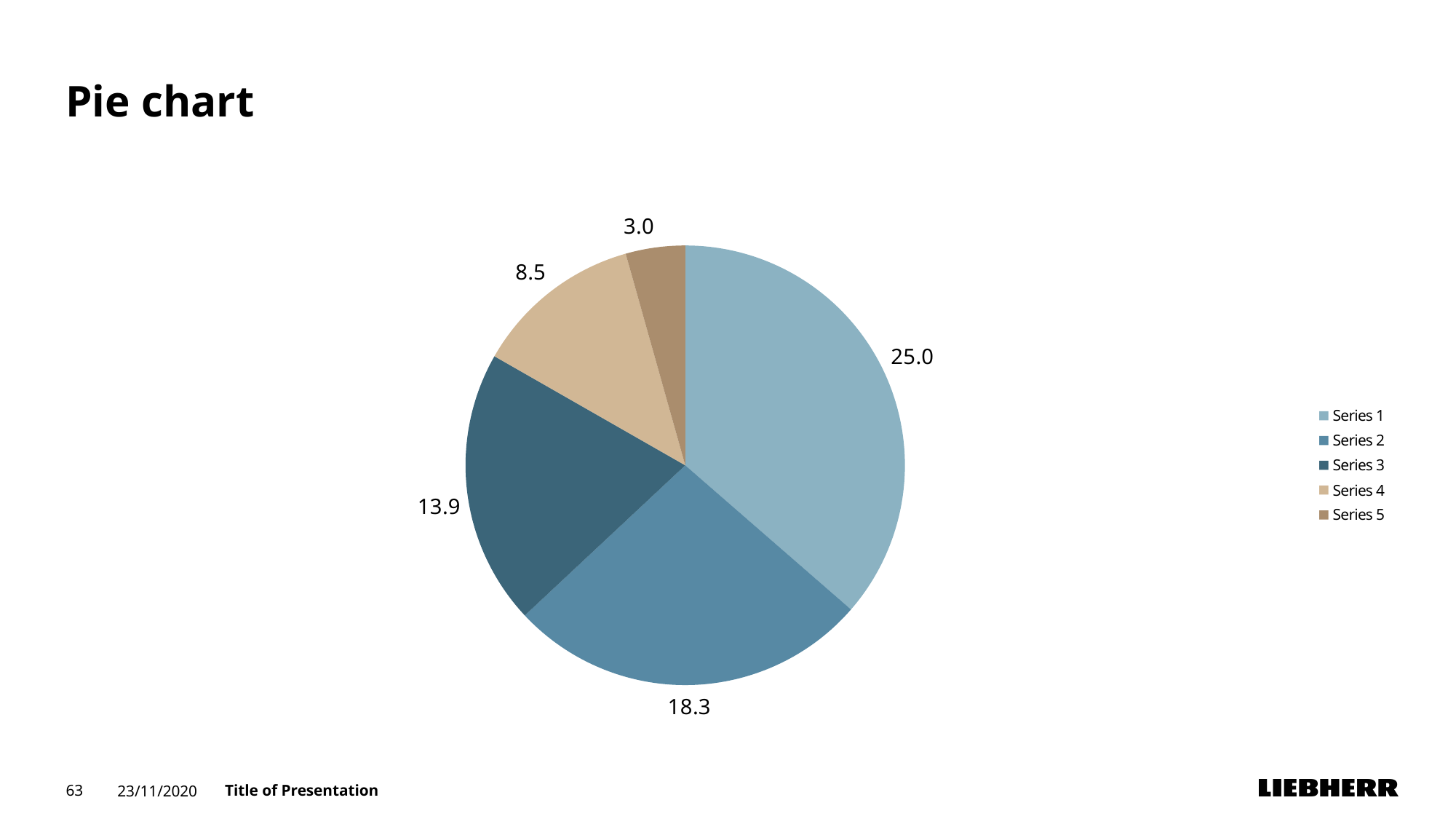
What kind of chart is shown on the slide? Pie chart How many entries does the legend list? 5 What is the value of the Series 5 slice? 3.0 What is the total of all the slice values? 68.7 Which series has the largest slice? Series 1 Which is larger, the Series 2 slice or the Series 3 slice? Series 2 What is the value of the Series 1 slice? 25.0 Which series has the smallest slice? Series 5 What is the difference between the Series 4 and Series 5 values? 5.5 How many slices does the pie chart have? 5 What is the difference between the Series 1 and Series 2 values? 6.7 What is the value of the Series 3 slice? 13.9